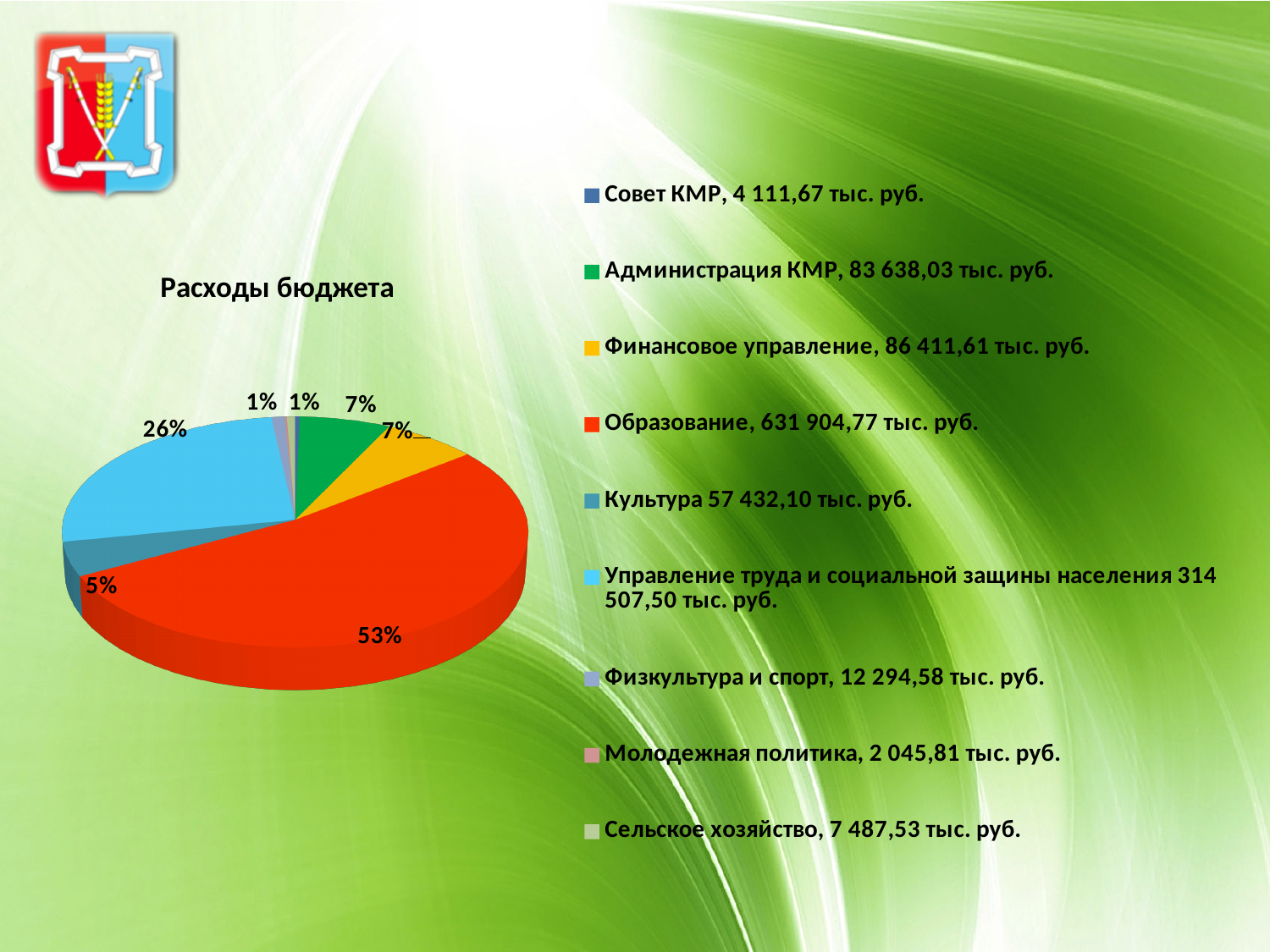
How many categories does the legend of the pie chart list? 9 Which category has the largest slice of the pie? Образование What is the title of the chart? Расходы бюджета What share of the pie does Управление труда и социальной защиты населения take? 26% What share of the pie does Культура take? 5% Which has the larger value in the legend, Финансовое управление or Администрация КМР? Финансовое управление What is the difference in percentage points between the Образование slice and the Управление труда и социальной защиты населения slice? 27% What is the value for Администрация КМР shown in the legend? 83 638,03 тыс. руб. What share of the pie does Образование take? 53% What is the value for Сельское хозяйство shown in the legend? 7 487,53 тыс. руб. What kind of chart is shown on the slide? pie chart Which category has the smallest value according to the legend? Молодежная политика